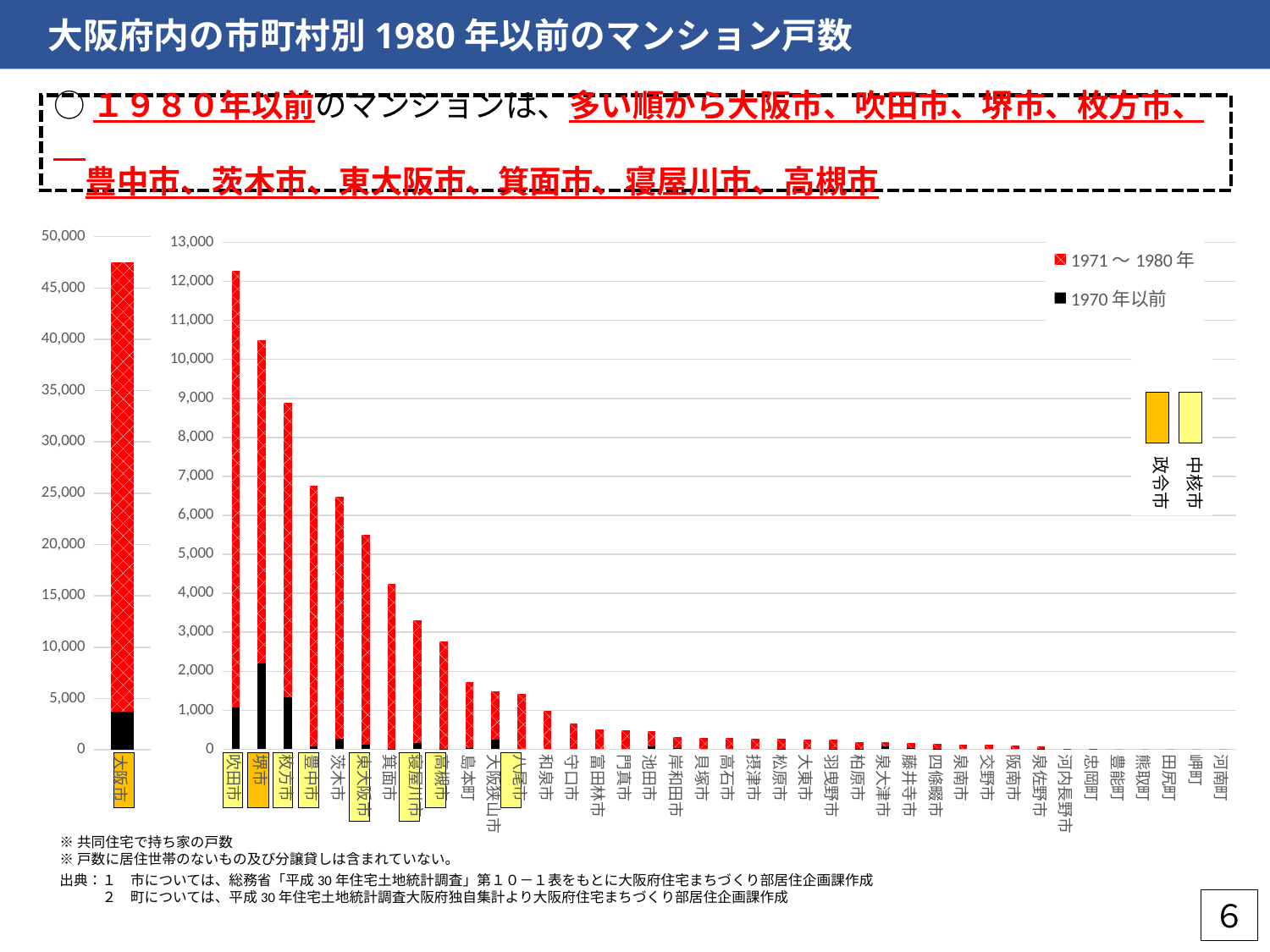
What kind of chart is used on this slide to show the number of condominium units by municipality? Stacked bar chart In the right-hand chart, which has a larger total, 箕面市 or 寝屋川市? 箕面市 In the left-hand chart, is the total value for 大阪市 greater or less than 45,000? greater In the right-hand chart, is the total value for 豊中市 greater or less than 7,000? less In the right-hand chart, is the total value for 東大阪市 greater or less than 5,000? greater How many series does the legend of the right-hand chart list? 2 In the right-hand chart, do the total values rise or fall moving from left to right along the x axis? fall Which legend entry is shown with the black solid fill in the chart? 1970年以前 In the right-hand chart (municipalities other than 大阪市), which municipality has the highest total number of units? 吹田市 How many municipalities are shown on the x axis of the right-hand chart? 39